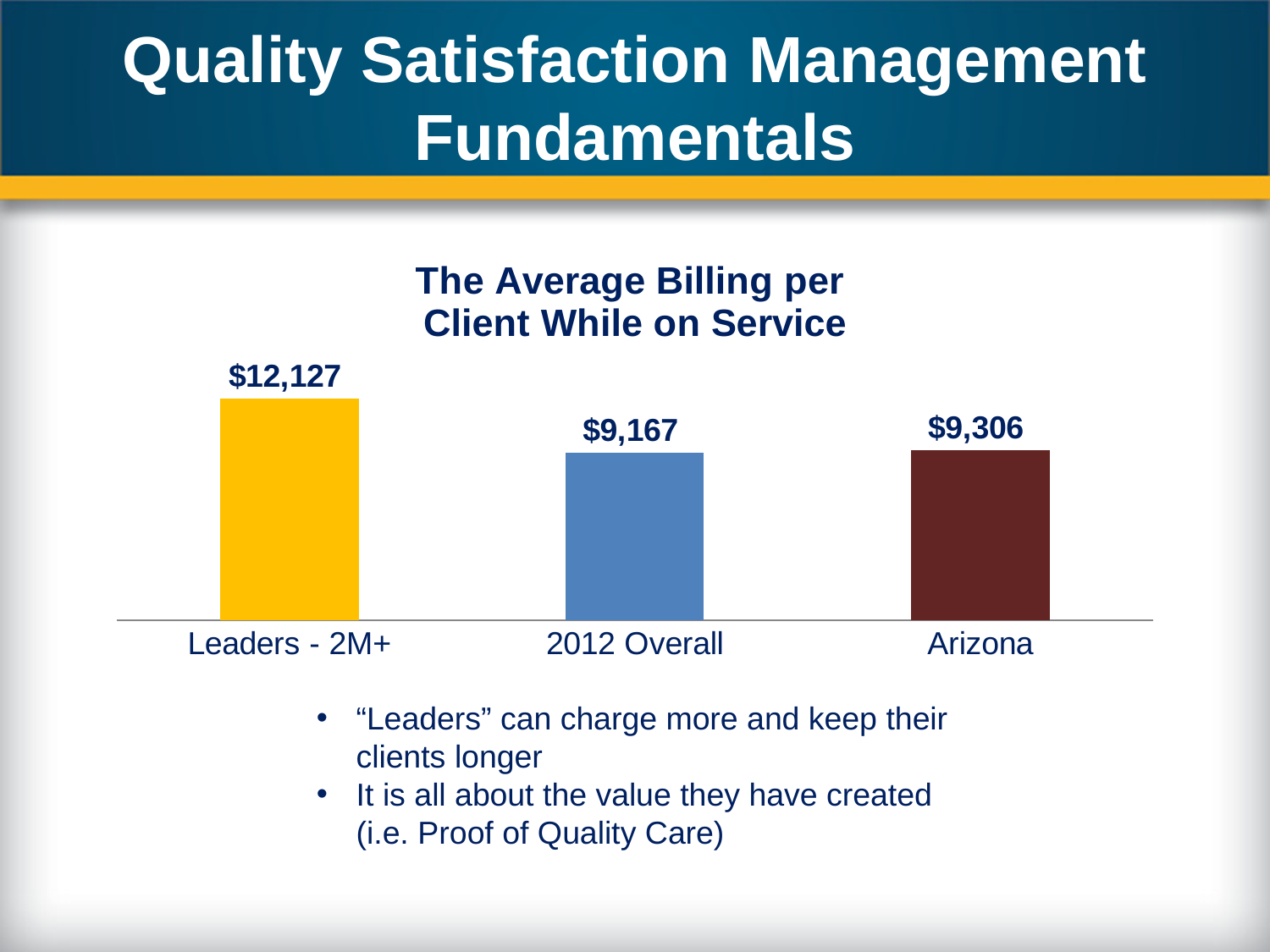
Which category has the lowest average billing per client? 2012 Overall What is the average billing per client for Leaders - 2M+? $12,127 How many categories are shown in the chart? 3 What is the difference in average billing per client between Arizona and 2012 Overall? $139 Which category has the highest average billing per client? Leaders - 2M+ What is the difference in average billing per client between Leaders - 2M+ and Arizona? $2,821 Which has a higher average billing per client, Arizona or 2012 Overall? Arizona What is the average billing per client for Arizona? $9,306 What is the average billing per client for 2012 Overall? $9,167 What is the difference in average billing per client between Leaders - 2M+ and 2012 Overall? $2,960 What kind of chart is shown on the slide? Bar chart What is the title of the chart? The Average Billing per Client While on Service